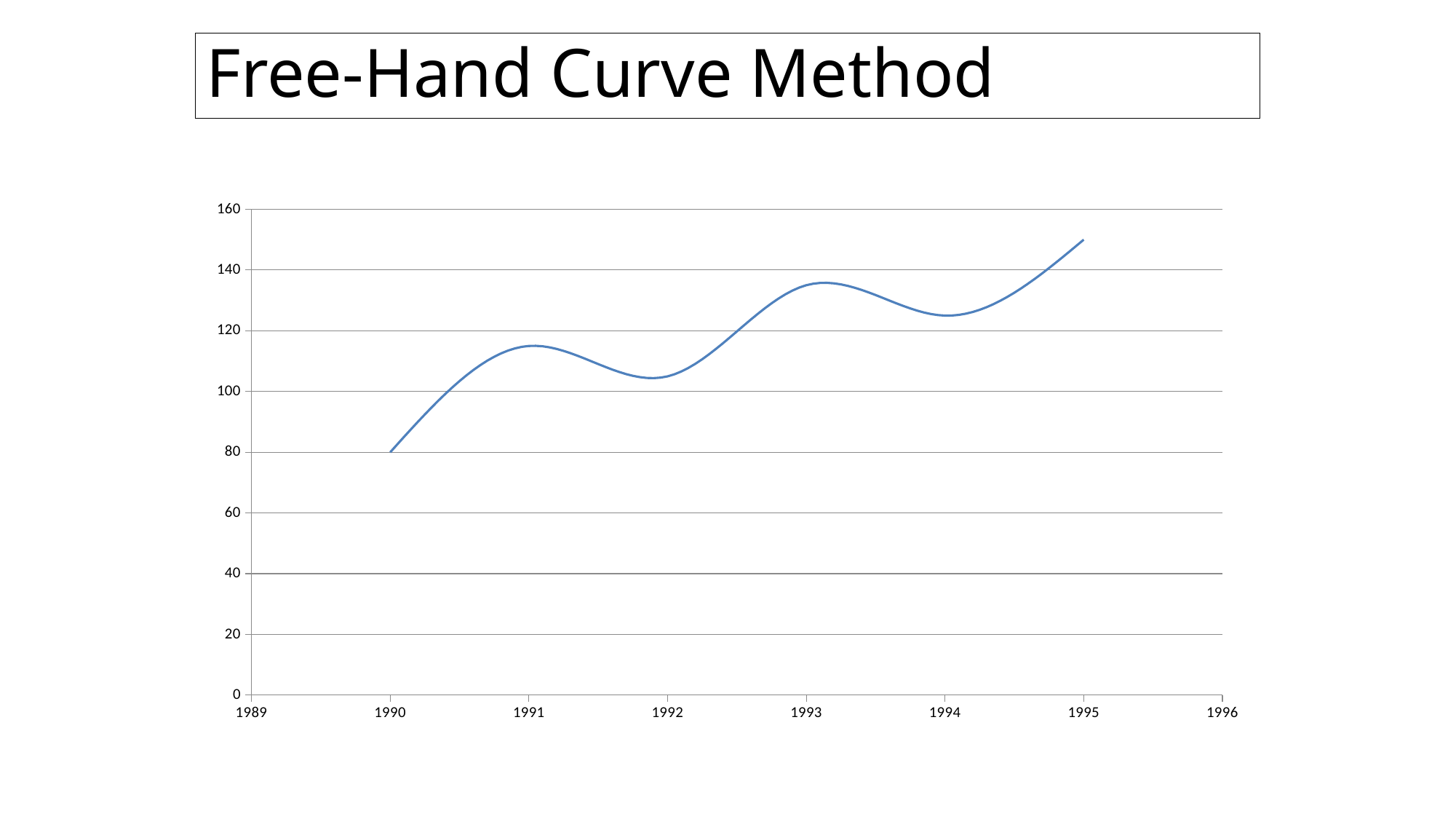
In which year does the line reach its highest value? 1995 In which year does the line have its lowest value? 1990 Which year has the larger value, 1992 or 1993? 1993 Is the value of the line at 1994 greater or less than 140? less What is the value of the line at 1990? 80 Overall, does the line rise or fall from 1990 to 1995? rise Is the value of the line at 1995 greater or less than 140? greater What is the title of the slide? Free-Hand Curve Method Is the value of the line at 1992 greater or less than 120? less What kind of chart is shown on the slide? line chart